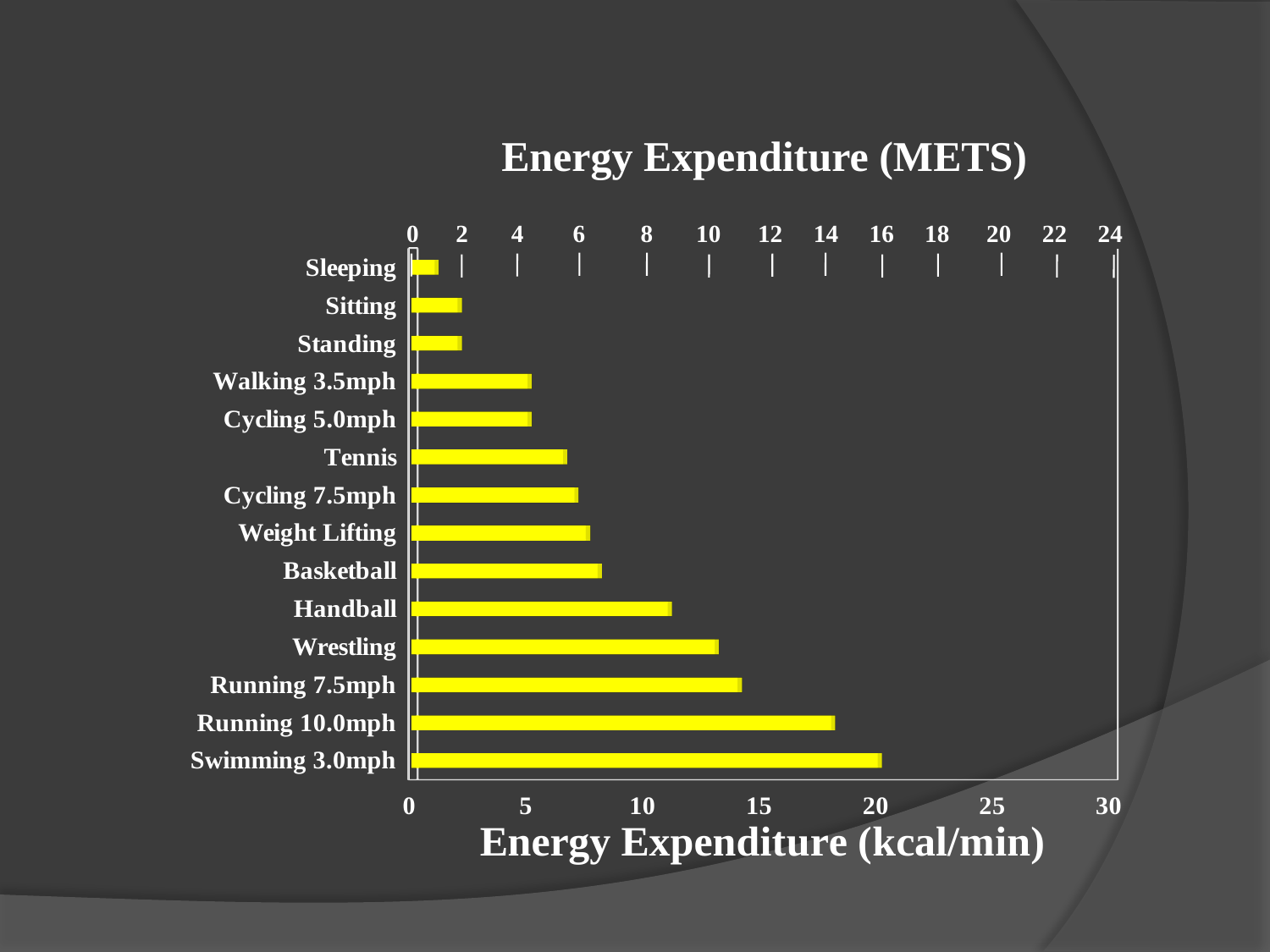
What is the label on the bottom horizontal axis of the chart? Energy Expenditure (kcal/min) Do the bars generally get longer or shorter going from Sleeping at the top to Swimming 3.0mph at the bottom? longer Which has the longer bar, Tennis or Basketball? Basketball What is the title of the chart? Energy Expenditure (METS) Which has the longer bar, Running 10.0mph or Handball? Running 10.0mph On the bottom axis (kcal/min), is the value for Running 10.0mph greater or less than 15? greater On the bottom axis (kcal/min), is the value for Sleeping greater or less than 5? less Which activity has the shortest bar in the chart? Sleeping What kind of chart is shown on the slide? bar chart How many activities are plotted in the chart? 14 On the bottom axis (kcal/min), is the value for Handball greater or less than 10? greater Which activity has the longest bar in the chart? Swimming 3.0mph